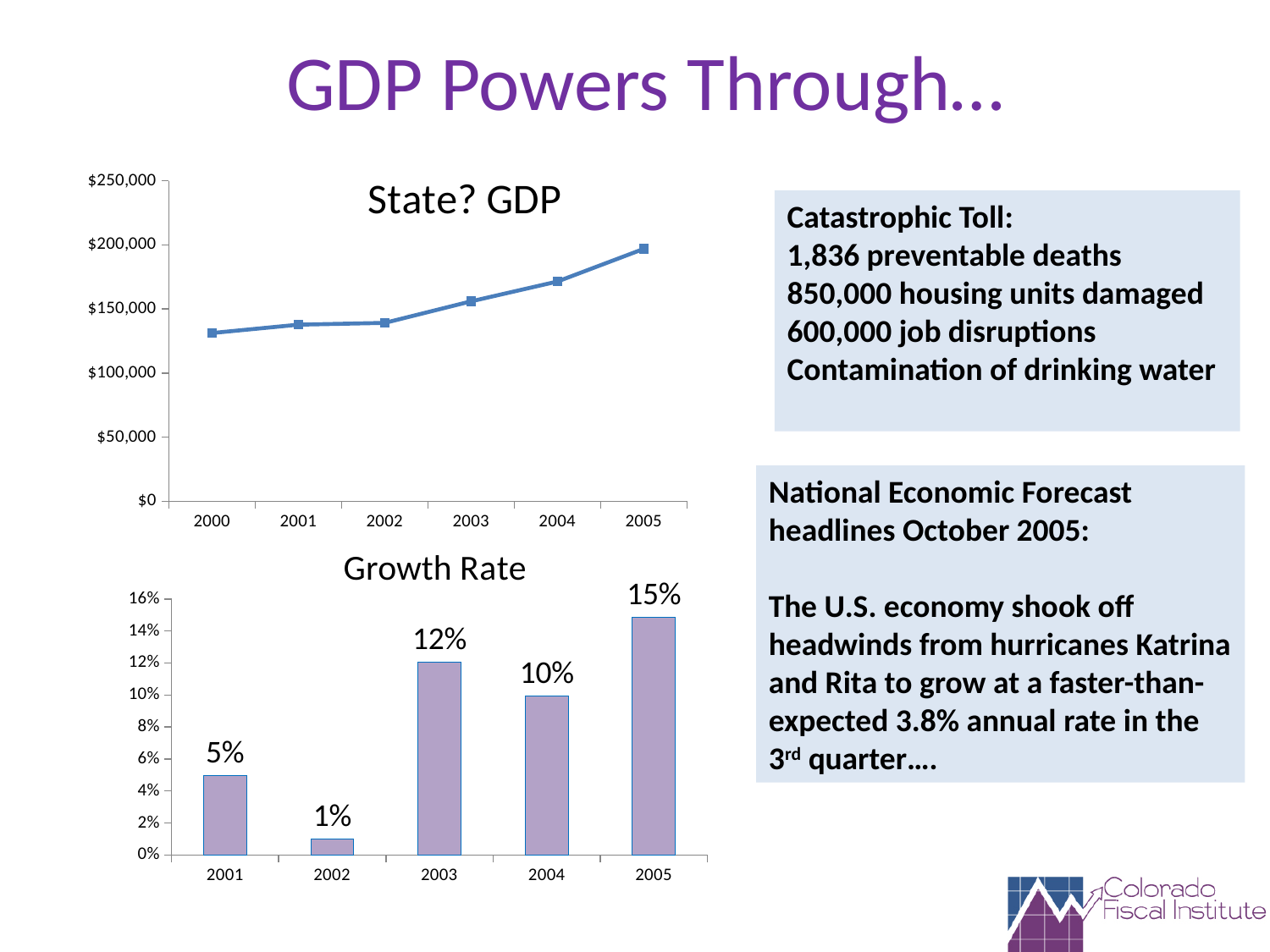
In the Growth Rate chart, which year has the highest growth rate? 2005 In the State? GDP chart, how many years are plotted? 6 In the State? GDP chart, is the value for 2005 greater or less than $150,000? greater In the Growth Rate chart, what is the growth rate for 2003? 12% In the Growth Rate chart, what is the growth rate for 2001? 5% In the State? GDP chart, is the value for 2000 greater or less than $150,000? less In the Growth Rate chart, what is the difference between the growth rates for 2005 and 2002? 14% In the Growth Rate chart, which year has the lowest growth rate? 2002 In the Growth Rate chart, how many years are shown? 5 What kind of chart is the Growth Rate chart? Bar chart In the Growth Rate chart, which year has the larger growth rate, 2003 or 2004? 2003 In the State? GDP chart, do the values rise or fall from 2000 to 2005? Rise